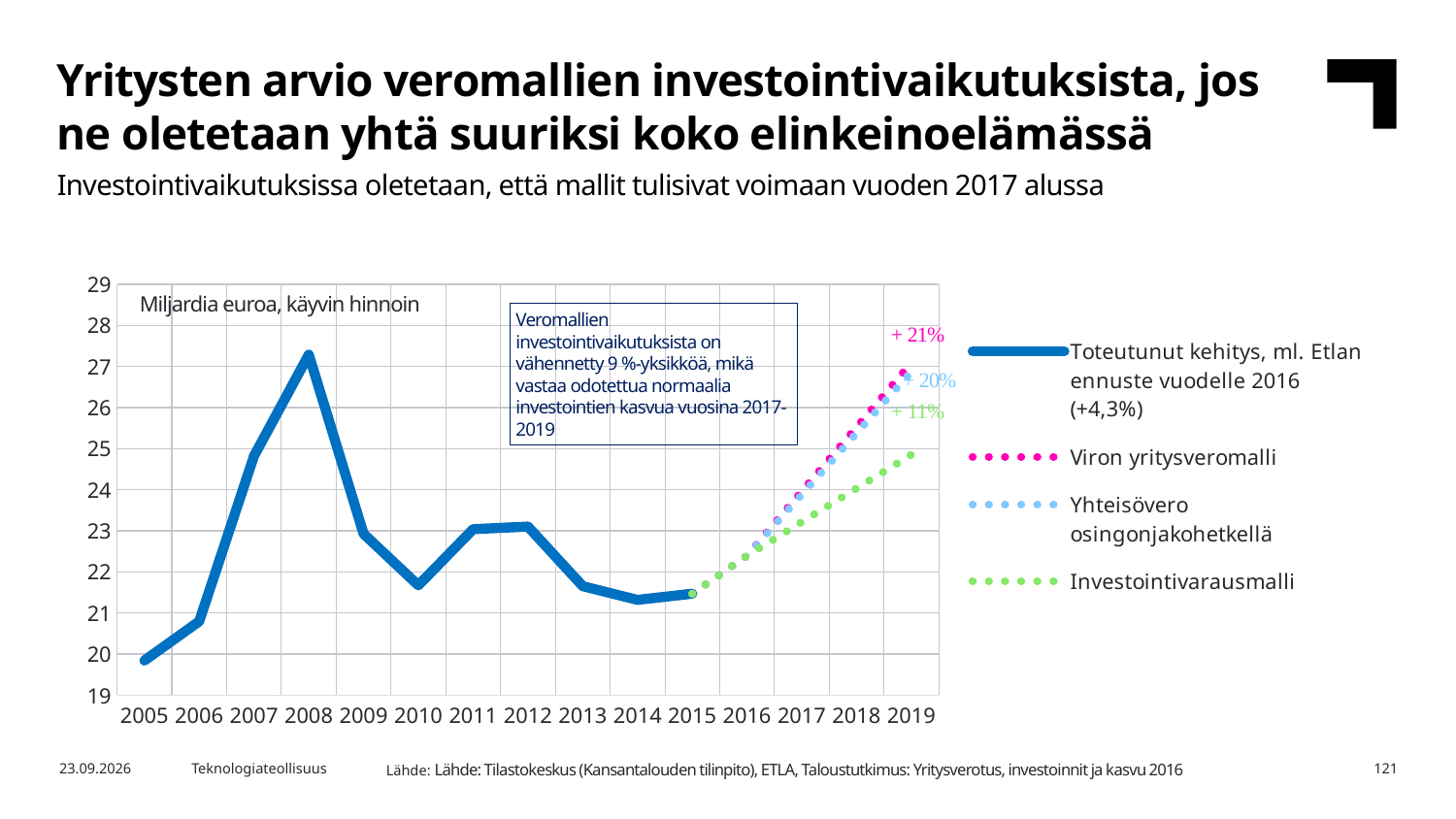
Is the value of the Toteutunut kehitys line in 2014 greater or less than 22? less Does the Toteutunut kehitys line rise or fall between 2005 and 2008? rise What percentage label is shown at the end of the Viron yritysveromalli series in 2019? + 21% In which year does the Toteutunut kehitys line reach its highest value? 2008 Is the value of the Toteutunut kehitys line in 2008 greater or less than 27? greater What percentage label is shown at the end of the Investointivarausmalli series in 2019? + 11% Which year has the larger value on the Toteutunut kehitys line, 2008 or 2012? 2008 How many years are shown on the x axis? 15 In which year is the Toteutunut kehitys line at its lowest value? 2005 What kind of chart is shown on the slide? line chart How many series does the legend list? 4 What percentage label is shown at the end of the Yhteisövero osingonjakohetkellä series in 2019? + 20%